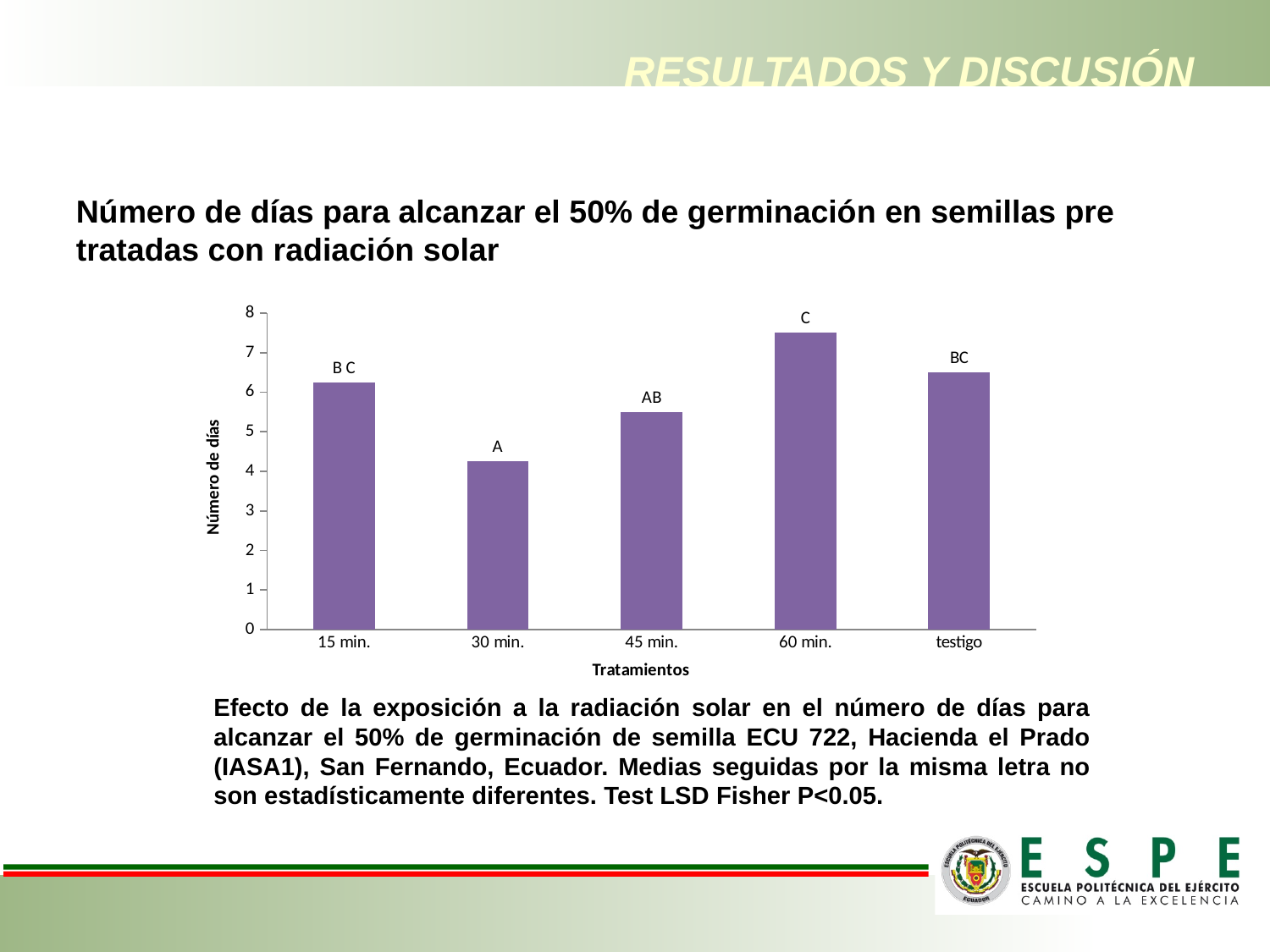
Is the value for 60 min. greater or less than 7? greater Is the value for 30 min. greater or less than 5? less Which treatment has the lowest number of days to reach 50% germination? 30 min. Which has a higher value, 45 min. or testigo? testigo What statistical letter label appears above the 60 min. bar? C What kind of chart is shown on the slide? bar chart Is the value for testigo greater or less than 7? less Which treatment has the highest number of days to reach 50% germination? 60 min. Which has a higher value, 15 min. or 30 min.? 15 min. How many treatment categories are shown on the x axis? 5 What is the title of the y axis? Número de días